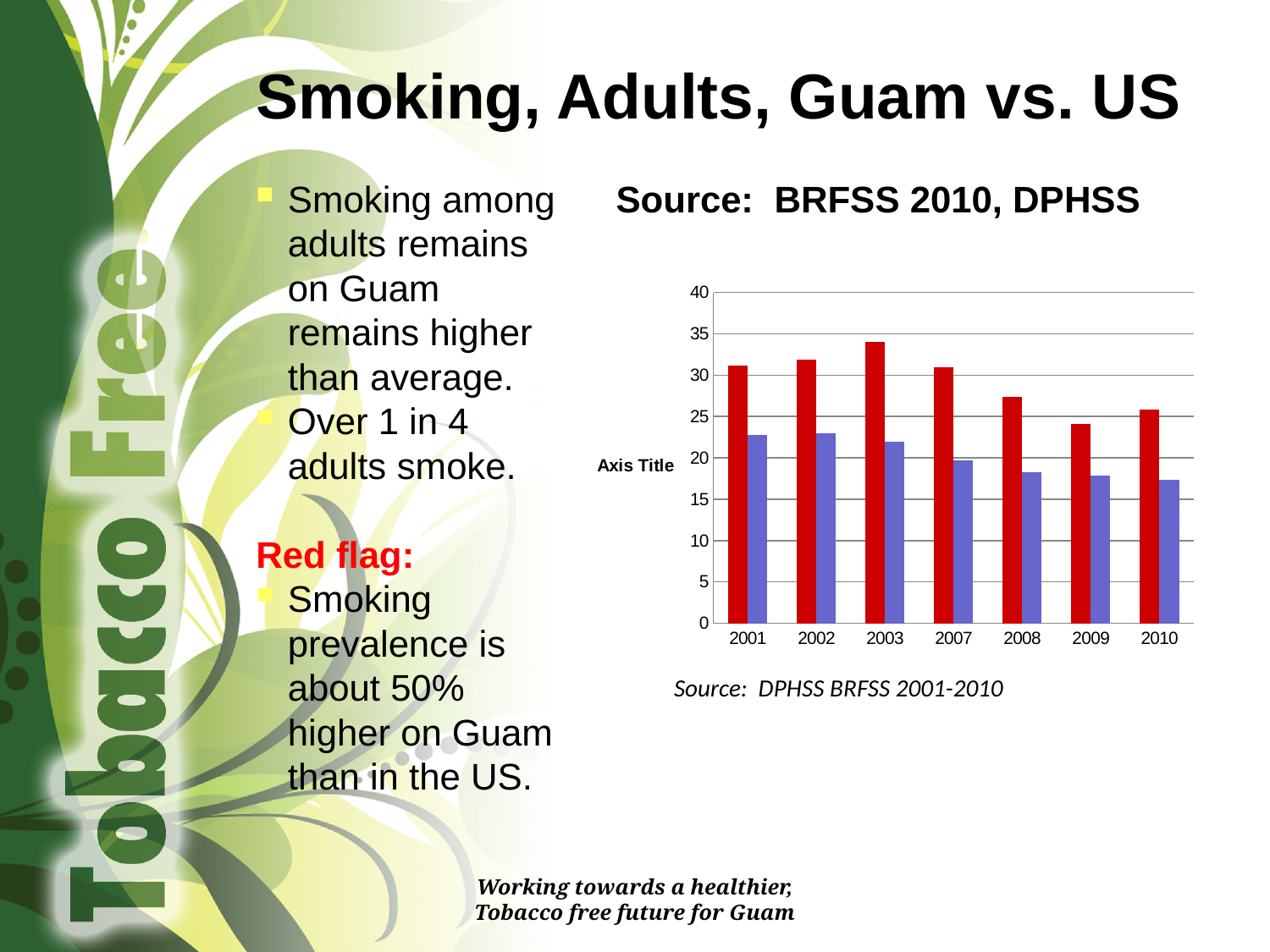
Do the blue bars generally rise or fall from 2001 to 2010? fall Is the red bar for 2009 greater or less than 25? less Is the blue bar for 2010 greater or less than 20? less In which year is the red bar the shortest? 2009 How many bars are plotted for each year in the chart? 2 In 2008, which bar is taller, the red bar or the blue bar? the red bar Is the red bar for 2003 greater or less than 30? greater What text is shown as the vertical axis title of the chart? Axis Title In which year is the red bar the tallest? 2003 What kind of chart is shown on the slide? bar chart How many years are shown on the x axis of the chart? 7